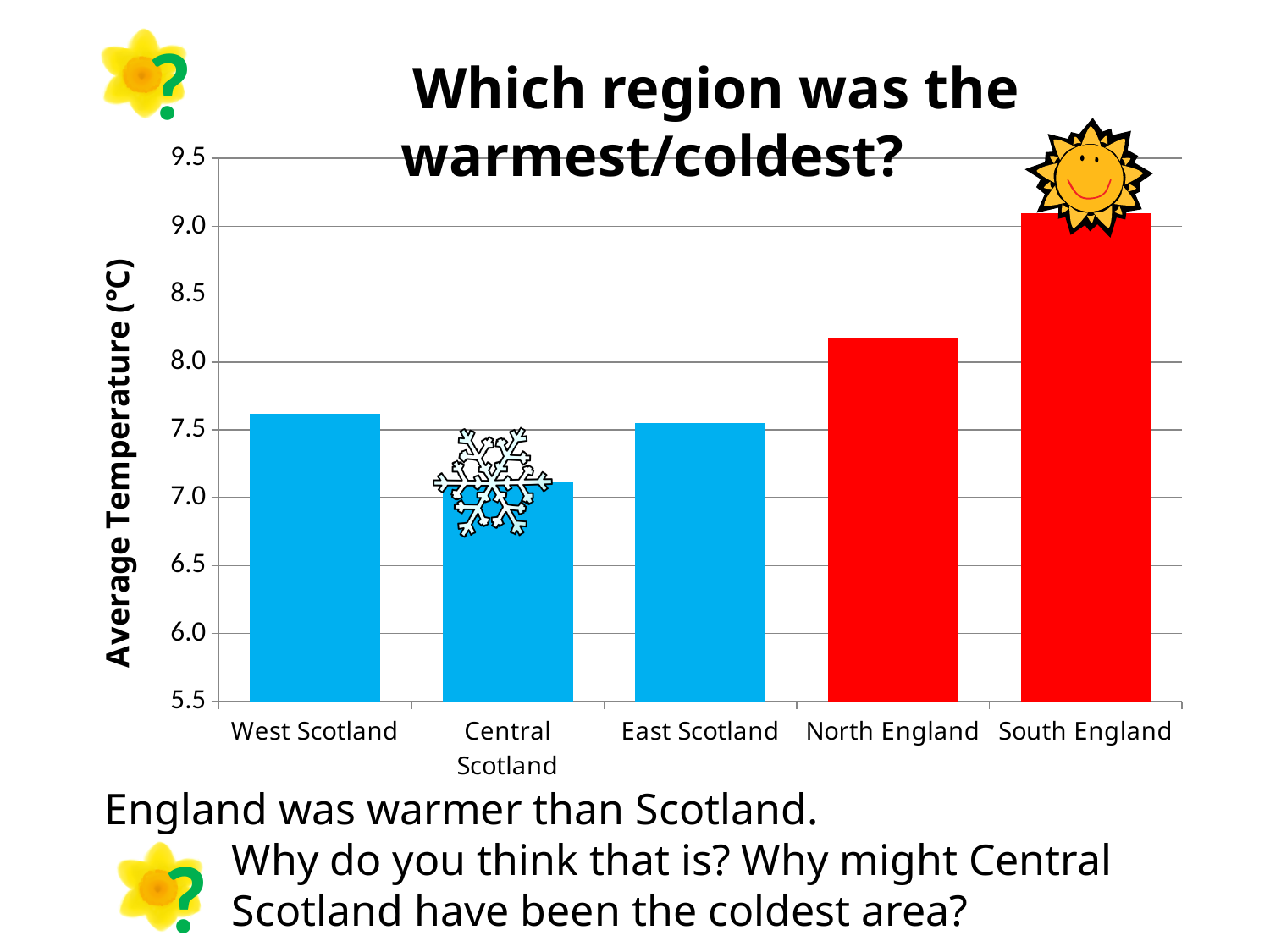
How many regions are shown on the chart? 5 Which region has the highest average temperature? South England Is the average temperature for Central Scotland greater or less than 7.5? less Which has a higher average temperature, North England or West Scotland? North England Is the average temperature for West Scotland greater or less than 8.0? less Which region has the lowest average temperature? Central Scotland What colour are the bars for the England regions? red What is the label on the vertical axis of the chart? Average Temperature (°C) Is the average temperature for North England greater or less than 8.0? greater What kind of chart is shown on the slide? bar chart